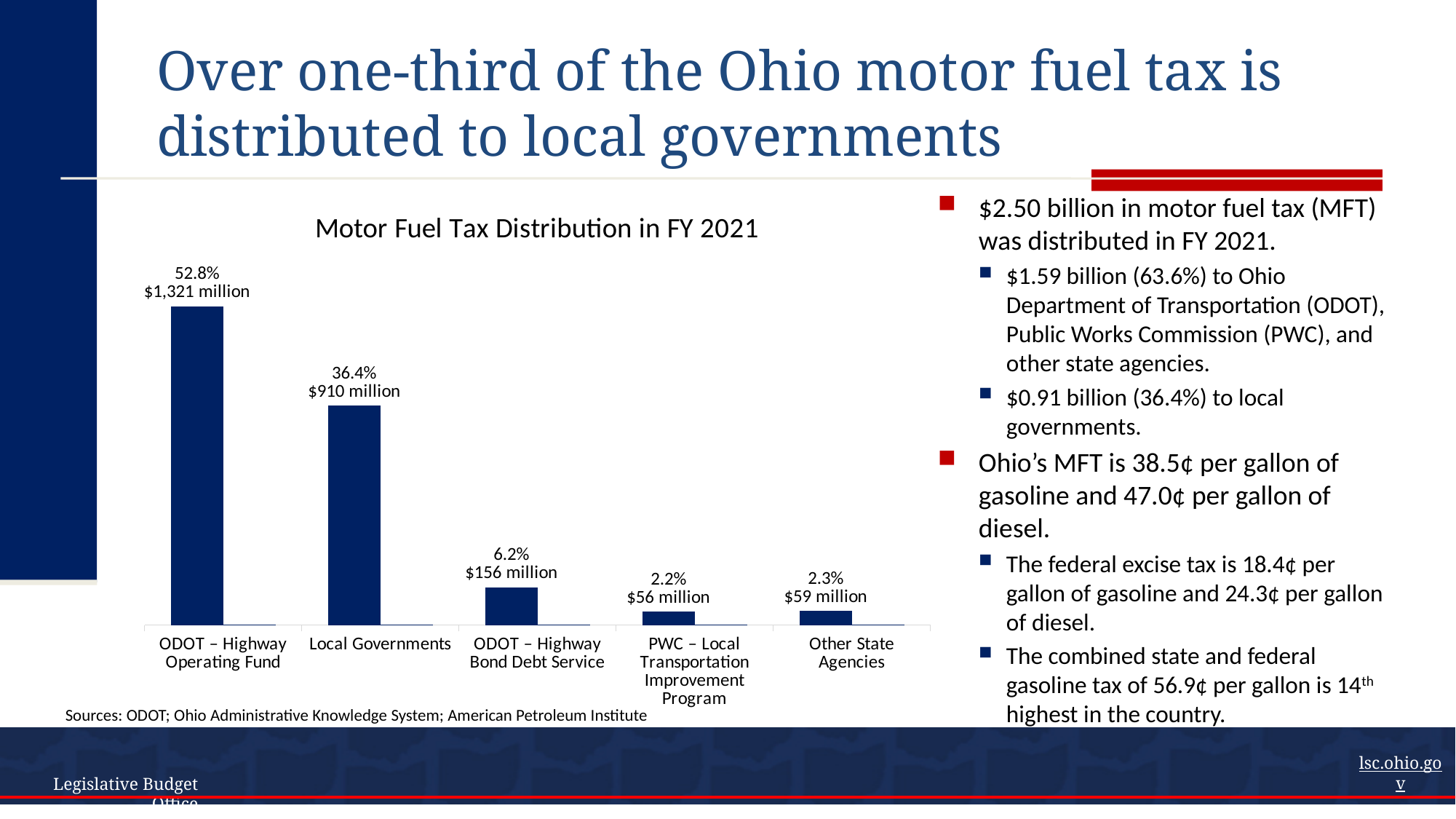
What percentage is shown for PWC – Local Transportation Improvement Program? 2.2% What kind of chart is shown on the slide? bar chart Which is larger, the value for Other State Agencies or the value for ODOT – Highway Bond Debt Service? ODOT – Highway Bond Debt Service What is the title of the chart? Motor Fuel Tax Distribution in FY 2021 How many categories are shown in the chart? 5 Which category has the lowest dollar amount? PWC – Local Transportation Improvement Program What dollar amount is shown for Local Governments? $910 million What dollar amount is shown for ODOT – Highway Bond Debt Service? $156 million Do the values generally rise or fall from left to right across the chart? fall Which category has the highest value? ODOT – Highway Operating Fund What is the difference in dollar amount between ODOT – Highway Operating Fund and Local Governments? $411 million What percentage is shown for ODOT – Highway Operating Fund? 52.8%